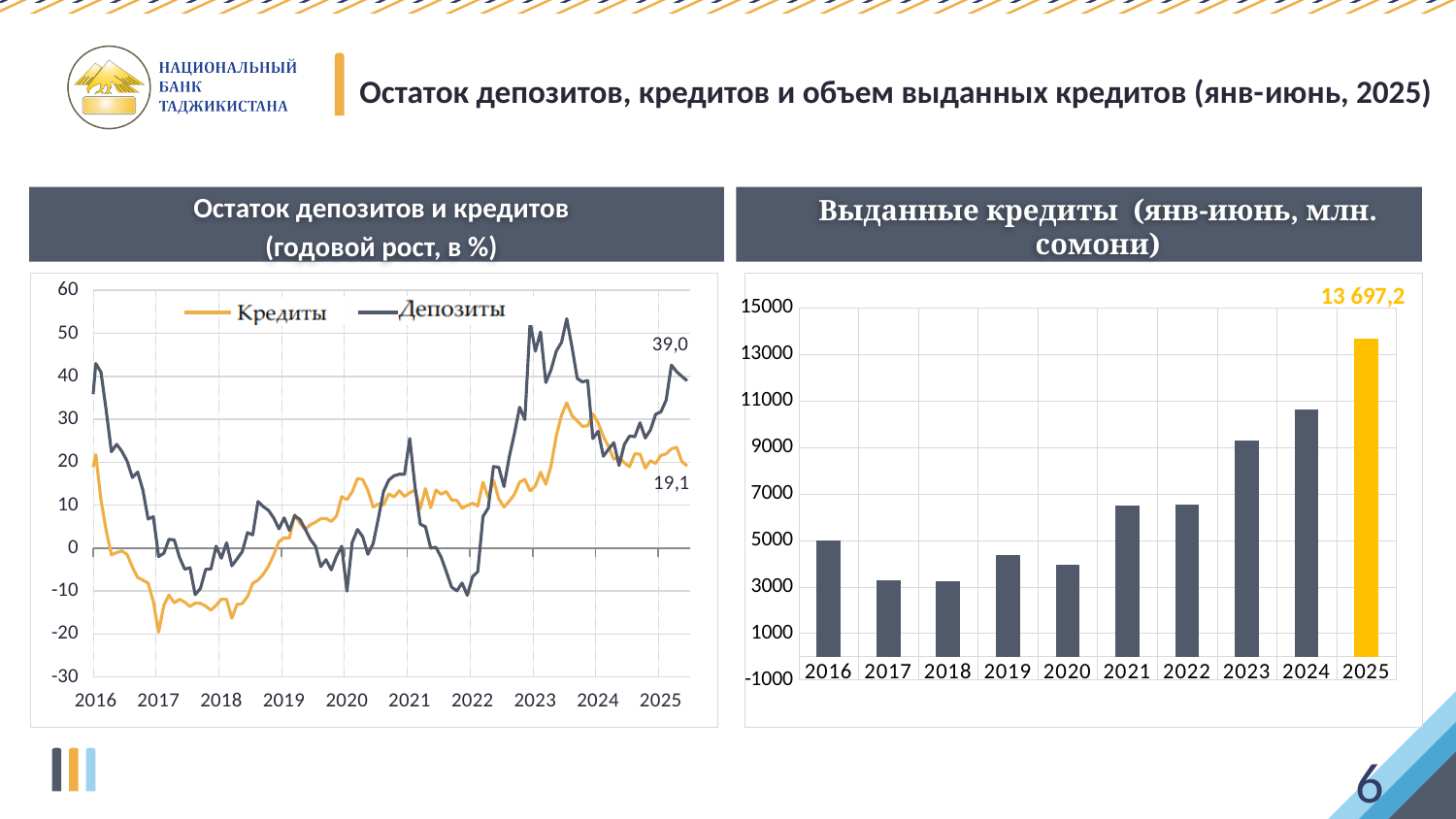
In the right chart (Выданные кредиты), which is larger, the value for 2023 or the value for 2020? 2023 How many series does the legend of the left chart (Остаток депозитов и кредитов) list? 2 In the right chart (Выданные кредиты), how many years are shown? 10 In the left chart (Остаток депозитов и кредитов), what is the latest labelled value for Депозиты? 39,0 In the right chart (Выданные кредиты), what is the value for 2025? 13 697,2 What kind of chart is the right chart (Выданные кредиты)? bar chart In the right chart (Выданные кредиты), what colour is the bar for 2025? yellow In the left chart (Остаток депозитов и кредитов), what is the difference between the latest labelled values for Депозиты (39,0) and Кредиты (19,1)? 19,9 What kind of chart is the left chart (Остаток депозитов и кредитов)? line chart In the right chart (Выданные кредиты), is the value for 2024 greater or less than 9000? greater In the right chart (Выданные кредиты), is the value for 2016 greater or less than 7000? less In the right chart (Выданные кредиты), which year has the highest value? 2025